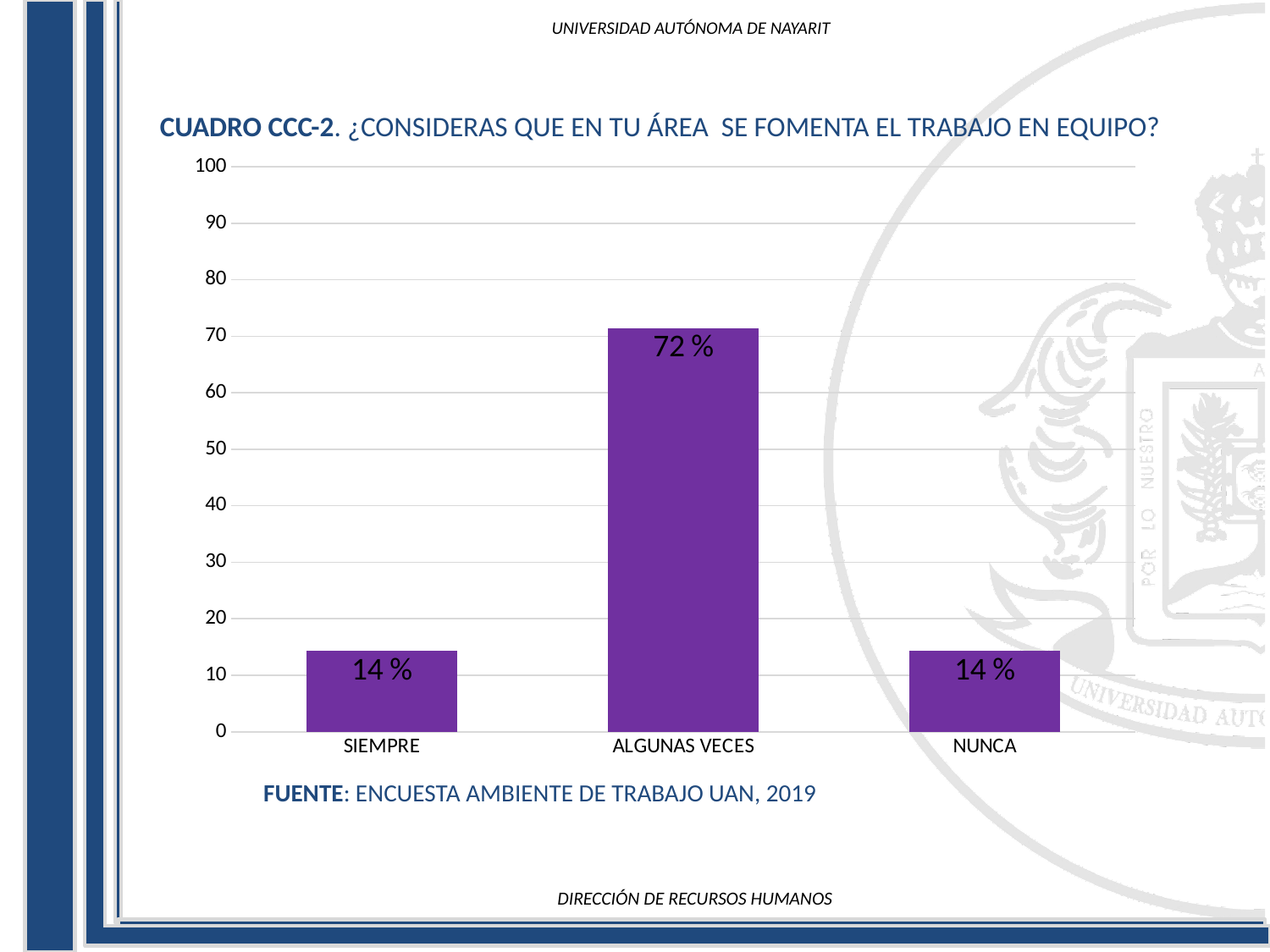
Which is larger, the value for ALGUNAS VECES or the value for NUNCA? ALGUNAS VECES Is the value for SIEMPRE greater or less than 20? less How many categories are shown on the x axis? 3 What is the value for NUNCA? 14 % Is the value for ALGUNAS VECES greater or less than 50? greater What is the maximum value shown on the y axis? 100 What is the difference between the values for ALGUNAS VECES and SIEMPRE? 58 % What kind of chart is shown on the slide? bar chart Which category has the highest value? ALGUNAS VECES What is the value for ALGUNAS VECES? 72 % What is the source cited below the chart? ENCUESTA AMBIENTE DE TRABAJO UAN, 2019 What is the value for SIEMPRE? 14 %